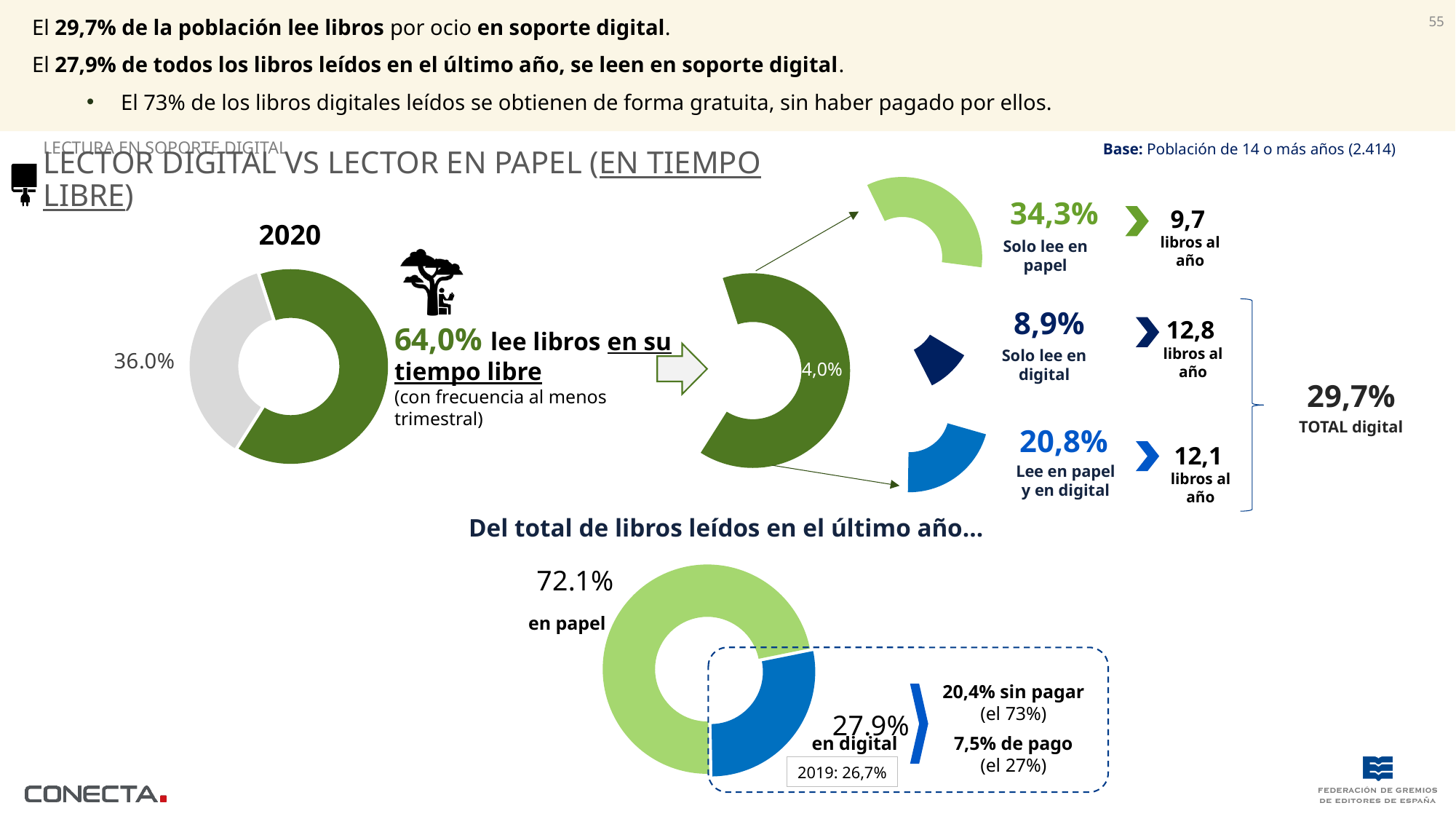
In the 2020 donut chart on the left, what is the value of the grey segment? 36.0% In the middle breakdown chart, how many books per year do people who read both on paper and in digital read? 12,1 In the bottom chart 'Del total de libros leídos en el último año…', what share of books are read on paper? 72.1% What kind of chart is used to show the 2020 free-time reading split on the left? donut (pie) chart In the 2020 donut chart on the left, which segment is larger, the green one or the grey one? the green one (64,0%) In the 2020 donut chart on the left, what is the difference between the green segment and the grey segment? 28 percentage points In the middle breakdown chart, what percentage of people only read on paper (Solo lee en papel)? 34,3% In the 2020 donut chart on the left, what percentage of people read books in their free time? 64,0% In the middle breakdown chart, which reader group is the smallest? Solo lee en digital (8,9%) In the middle breakdown chart, what percentage of people read both on paper and in digital? 20,8% In the bottom chart 'Del total de libros leídos en el último año…', what was the digital share in 2019? 26,7% In the middle breakdown chart, what percentage of people only read in digital (Solo lee en digital)? 8,9%